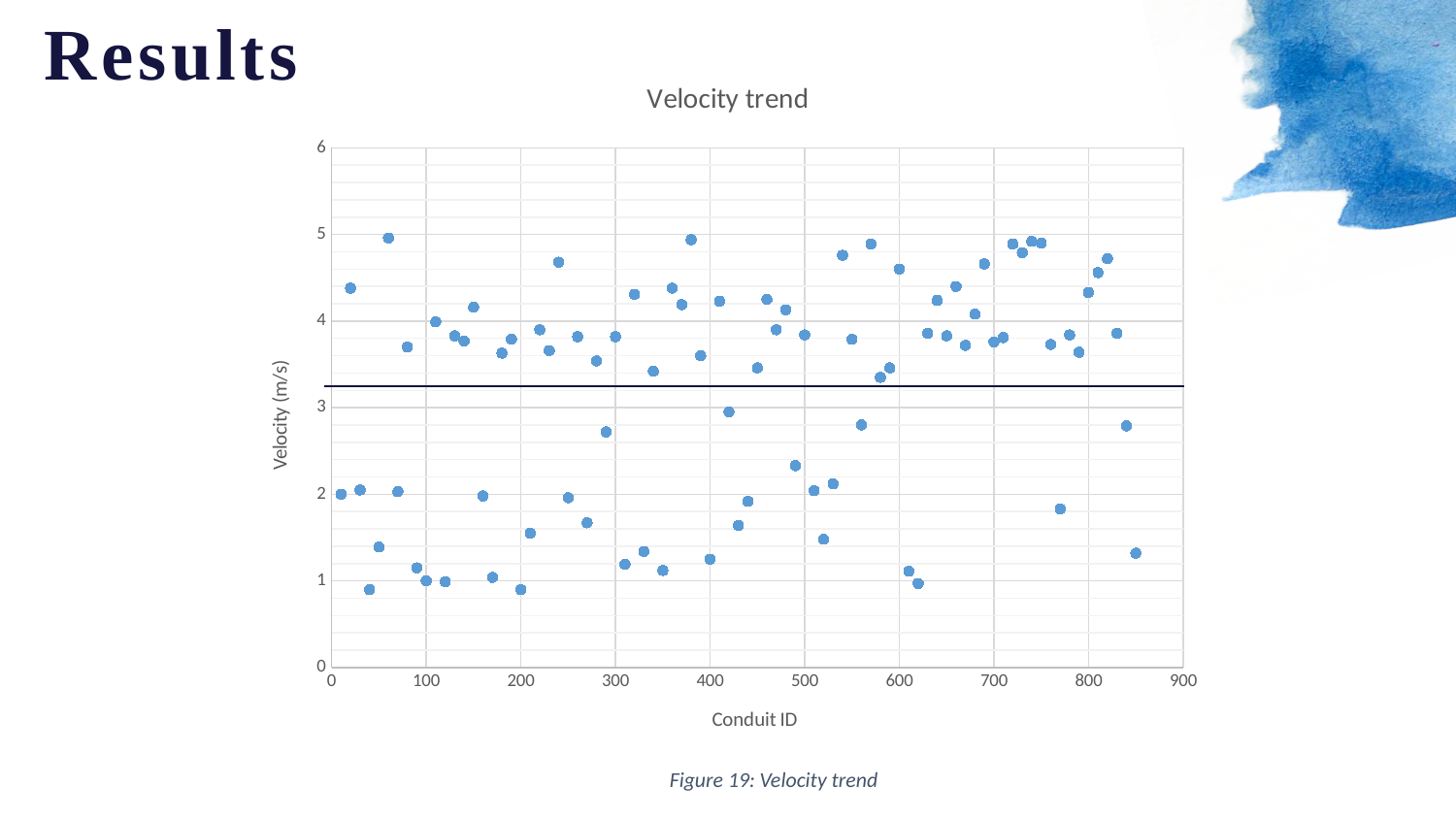
Is the lowest plotted velocity on the chart greater or less than 2? less What is the label of the y axis of the chart? Velocity (m/s) What is the title of the chart? Velocity trend Is the horizontal reference line on the chart at a velocity greater or less than 3? greater What kind of chart is shown on the slide? scatter chart Is the horizontal reference line on the chart at a velocity greater or less than 4? less